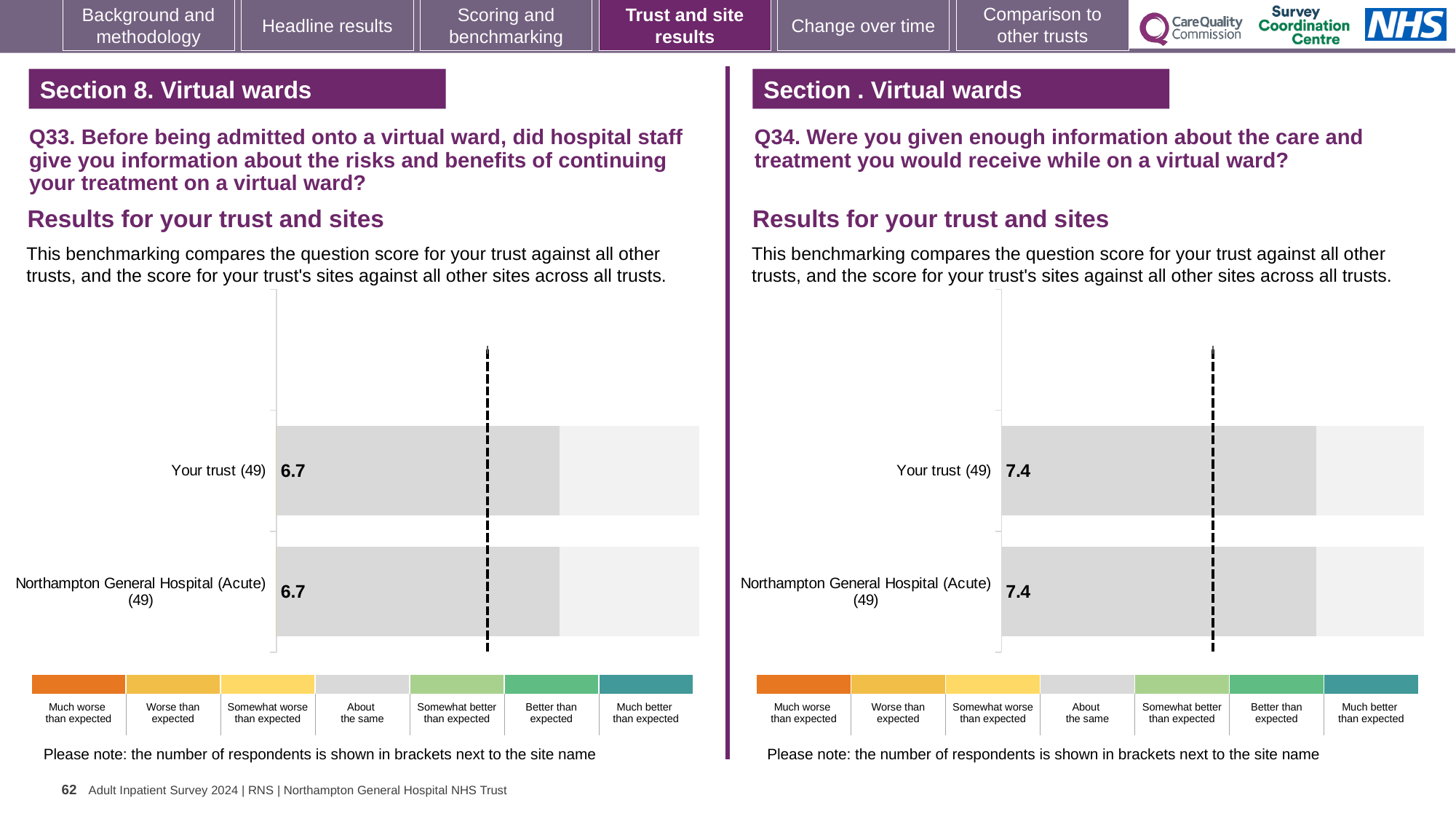
How many benchmark categories does the colour key below the Q34 chart on the right list? 7 In the Q33 chart on the left, what is the score for Northampton General Hospital (Acute) (49)? 6.7 What kind of chart is used for the Q33 results on the left? Bar chart In the Q34 chart on the right, what is the difference between the score for Your trust and the score for Northampton General Hospital (Acute)? 0 In the Q33 chart on the left, what is the score for Your trust (49)? 6.7 How many bars are plotted in the Q34 chart on the right? 2 In the Q33 chart on the left, what is the difference between the score for Your trust and the score for Northampton General Hospital (Acute)? 0 In the Q34 chart on the right, what is the score for Your trust (49)? 7.4 Is the Your trust score in the Q34 chart on the right larger than the Your trust score in the Q33 chart on the left? Yes How many respondents are shown in brackets next to Your trust in the Q33 chart on the left? 49 In the Q34 chart on the right, what is the score for Northampton General Hospital (Acute) (49)? 7.4 How many bars are plotted in the Q33 chart on the left? 2